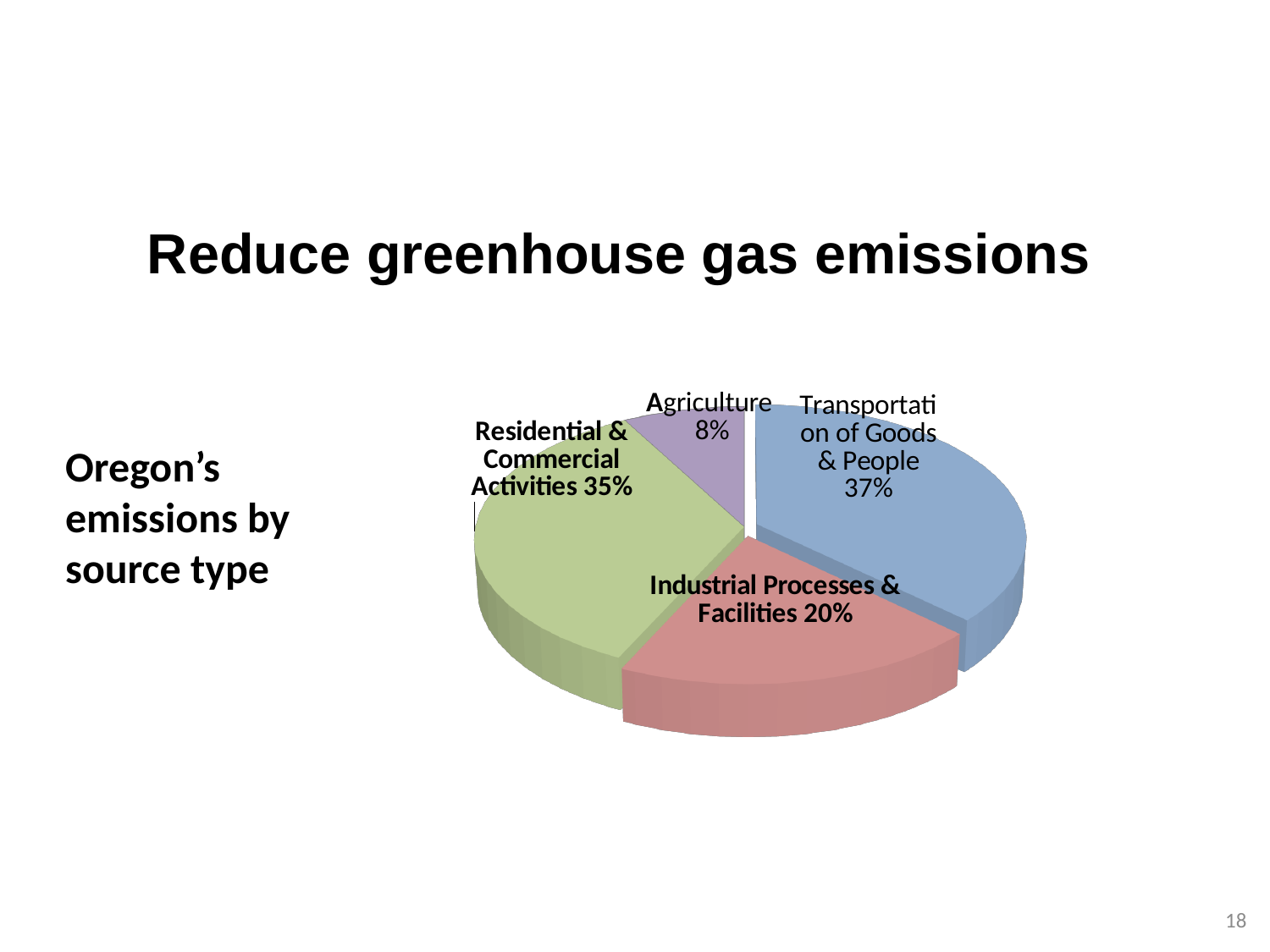
What colour is the Agriculture slice of the pie chart? Purple What share of Oregon's emissions comes from Residential & Commercial Activities? 35% What share of Oregon's emissions comes from Transportation of Goods & People? 37% Which source type accounts for the smallest share of Oregon's emissions? Agriculture What share of Oregon's emissions comes from Agriculture? 8% How many percentage points larger is the Transportation of Goods & People share than the Industrial Processes & Facilities share? 17 How many percentage points larger is the Residential & Commercial Activities share than the Agriculture share? 27 What share of Oregon's emissions comes from Industrial Processes & Facilities? 20% What kind of chart is shown on the slide? Pie chart How many source types are shown in the pie chart? 4 Which source type accounts for the largest share of Oregon's emissions? Transportation of Goods & People Which is larger: the share for Industrial Processes & Facilities or the share for Agriculture? Industrial Processes & Facilities